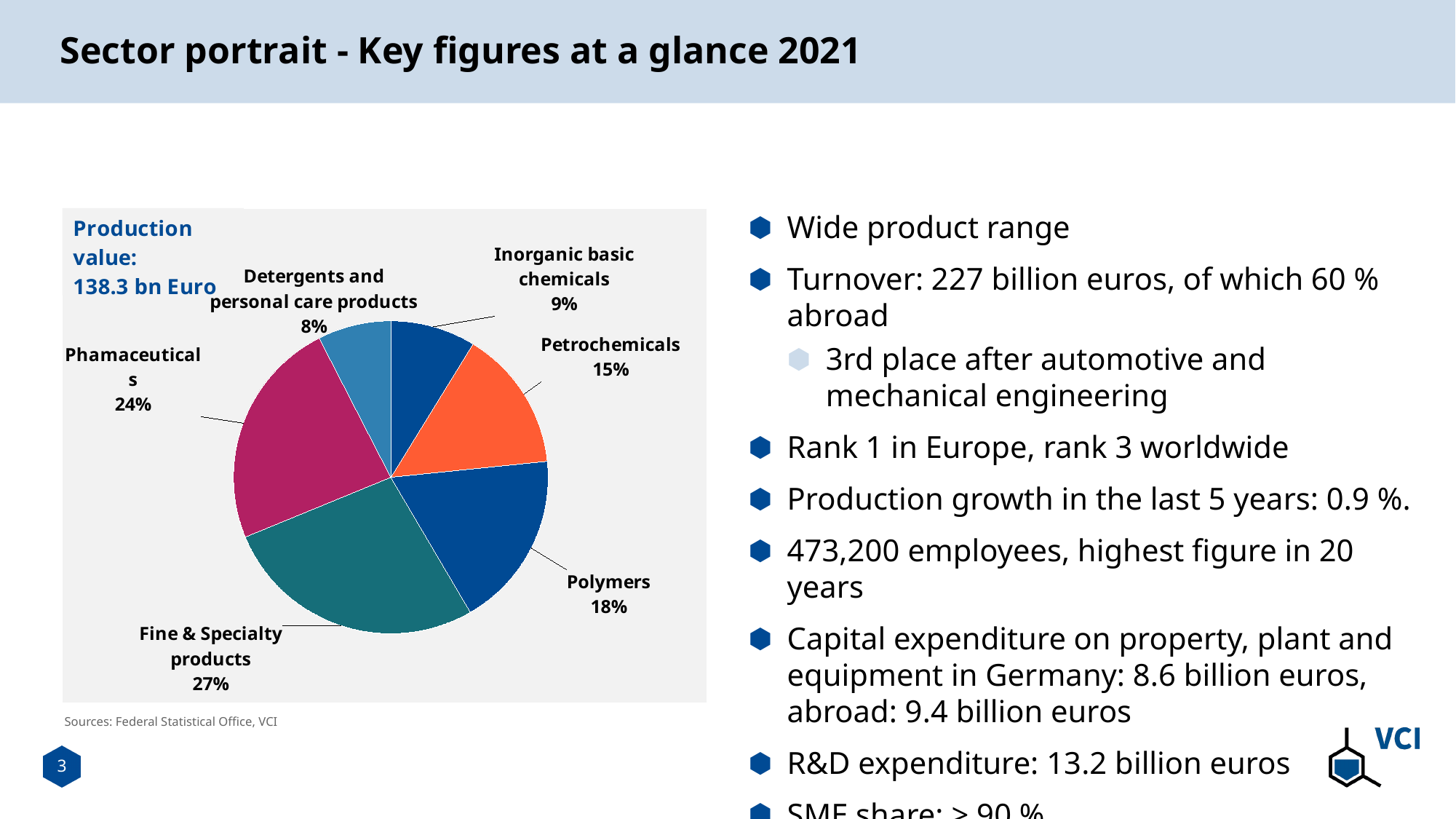
What kind of chart is shown on the slide? pie chart How many categories does the pie chart show? 6 Which category has the largest share of the pie? Fine & Specialty products What colour is the Petrochemicals slice? orange What is the combined share of Inorganic basic chemicals and Petrochemicals? 24% What total production value is stated on the chart? 138.3 bn Euro What is the difference in percentage points between Fine & Specialty products and Pharmaceuticals? 3 What share of production value do Petrochemicals account for? 15% What share of production value do Polymers account for? 18% What share of production value do Detergents and personal care products account for? 8% Which category has the smallest share of the pie? Detergents and personal care products Which is larger, the share for Polymers or the share for Petrochemicals? Polymers